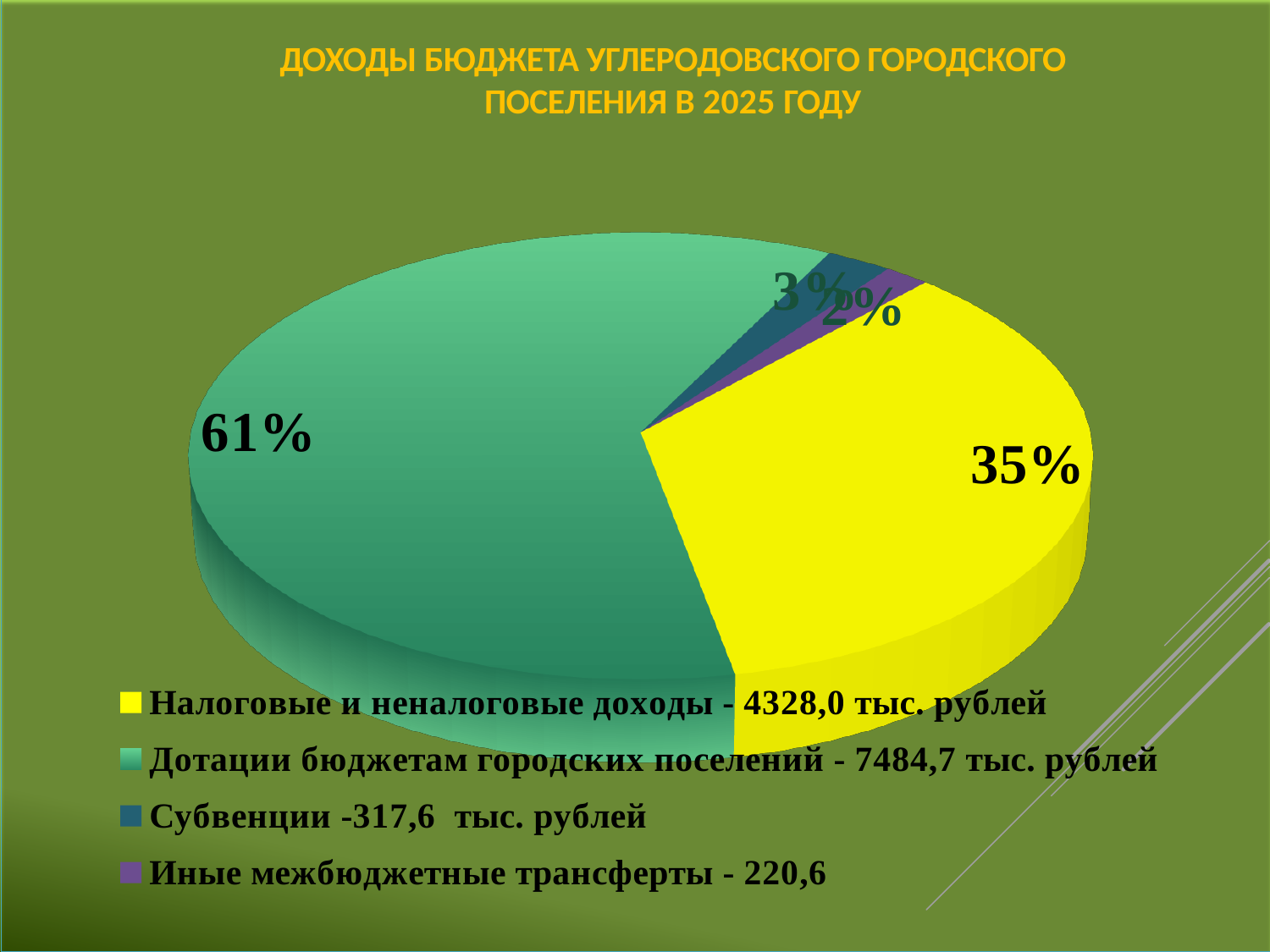
What share of the pie does "Дотации бюджетам городских поселений" take? 61% What kind of chart is shown on the slide? pie chart How many slices does the pie chart have? 4 What is the difference in percentage points between the "Дотации бюджетам городских поселений" slice and the "Налоговые и неналоговые доходы" slice? 26 Which category has the largest slice of the pie? Дотации бюджетам городских поселений According to the legend, what amount is given for "Субвенции"? 317,6 тыс. рублей What share of the pie does "Налоговые и неналоговые доходы" take? 35% Which is larger: the slice for "Субвенции" or the slice for "Иные межбюджетные трансферты"? Субвенции According to the legend, what amount is given for "Налоговые и неналоговые доходы"? 4328,0 тыс. рублей How many entries does the legend list? 4 What colour is the slice for "Налоговые и неналоговые доходы"? yellow Which category has the smallest slice of the pie? Иные межбюджетные трансферты